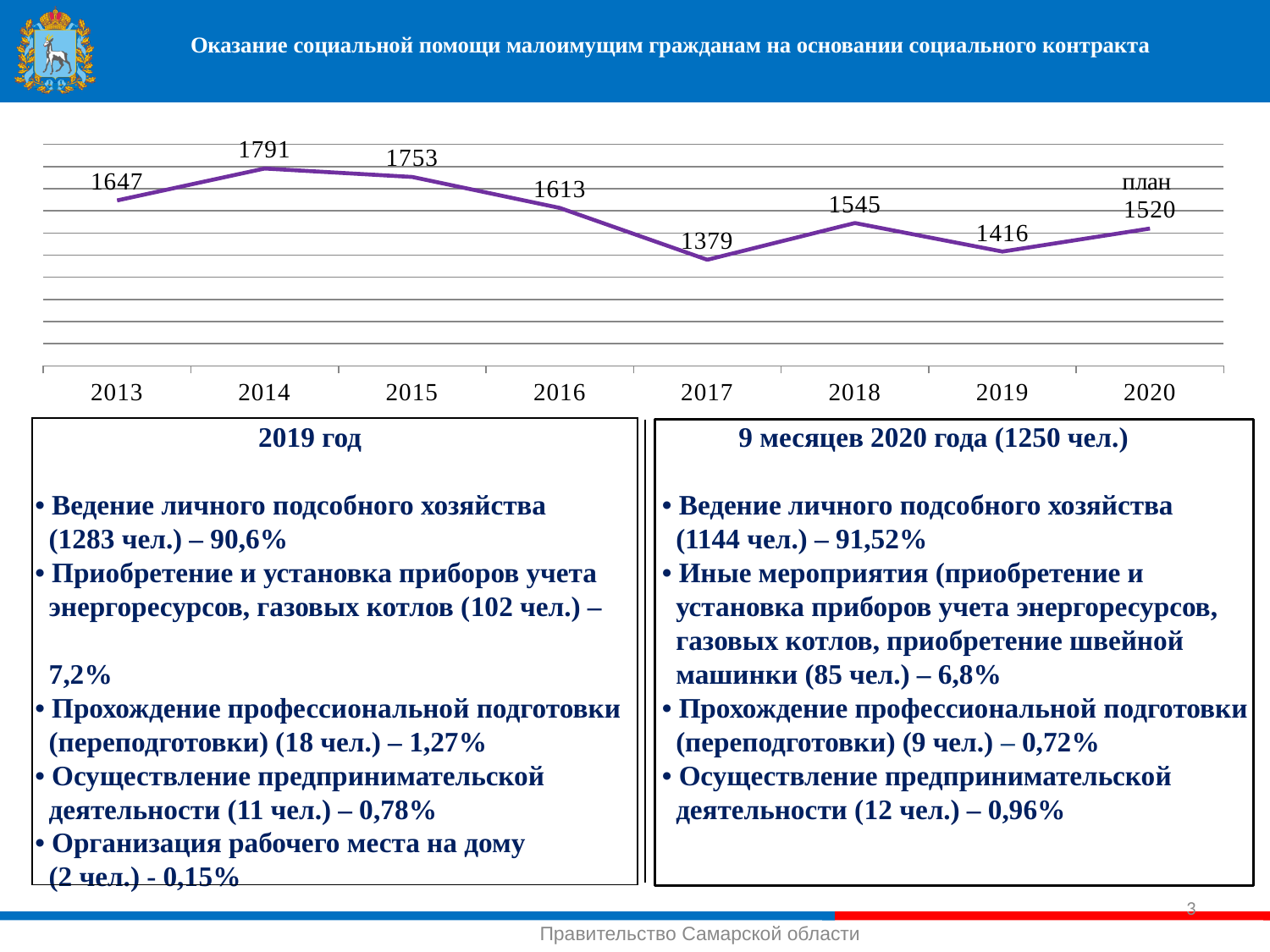
Which year has the highest value? 2014 What is the difference between the values for 2014 and 2017? 412 What label is shown next to the 2020 data point? план Which year has the lowest value? 2017 What is the planned (план) value for 2020? 1520 What is the value for 2017? 1379 What is the value for 2014? 1791 How many years are plotted on the chart? 8 Do the values rise or fall from 2014 to 2017? fall What kind of chart is shown on the slide? line chart What is the difference between the values for 2013 and 2019? 231 Which is larger, the value for 2018 or the value for 2019? 2018